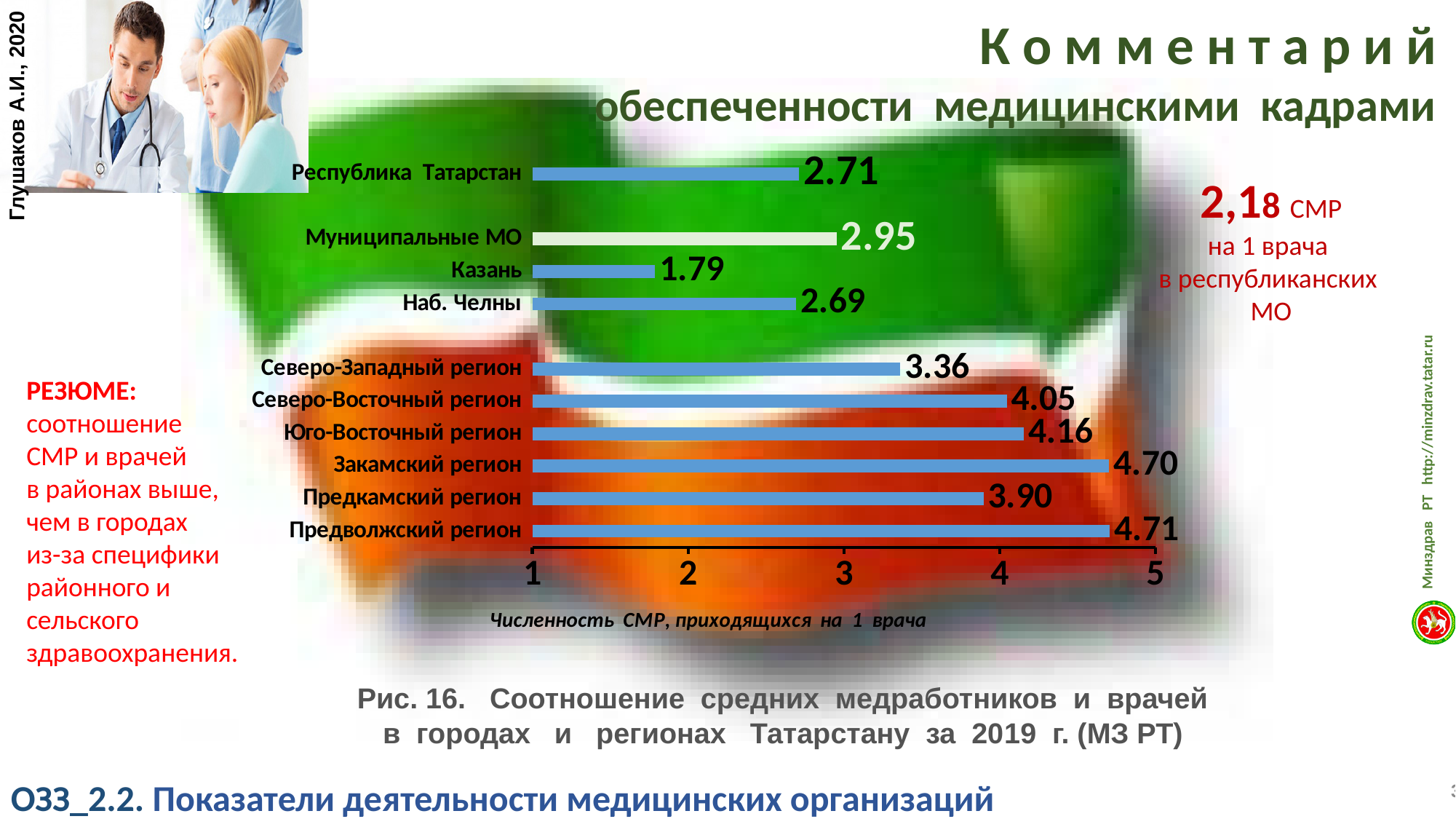
What is the value for Республика Татарстан? 2.71 What kind of chart is shown on the slide? bar chart What is the difference between the values for Юго-Восточный регион and Северо-Западный регион? 0.80 What is the value for Казань? 1.79 Is the value for Северо-Западный регион greater or less than 3? greater Which is larger, the value for Предкамский регион or the value for Северо-Восточный регион? Северо-Восточный регион What is the title of the horizontal axis of the chart? Численность СМР, приходящихся на 1 врача What is the value for Закамский регион? 4.70 What is the value for Муниципальные МО? 2.95 What is the difference between the values for Наб. Челны and Казань? 0.90 Which category has the lowest value? Казань How many categories are plotted in the chart? 10